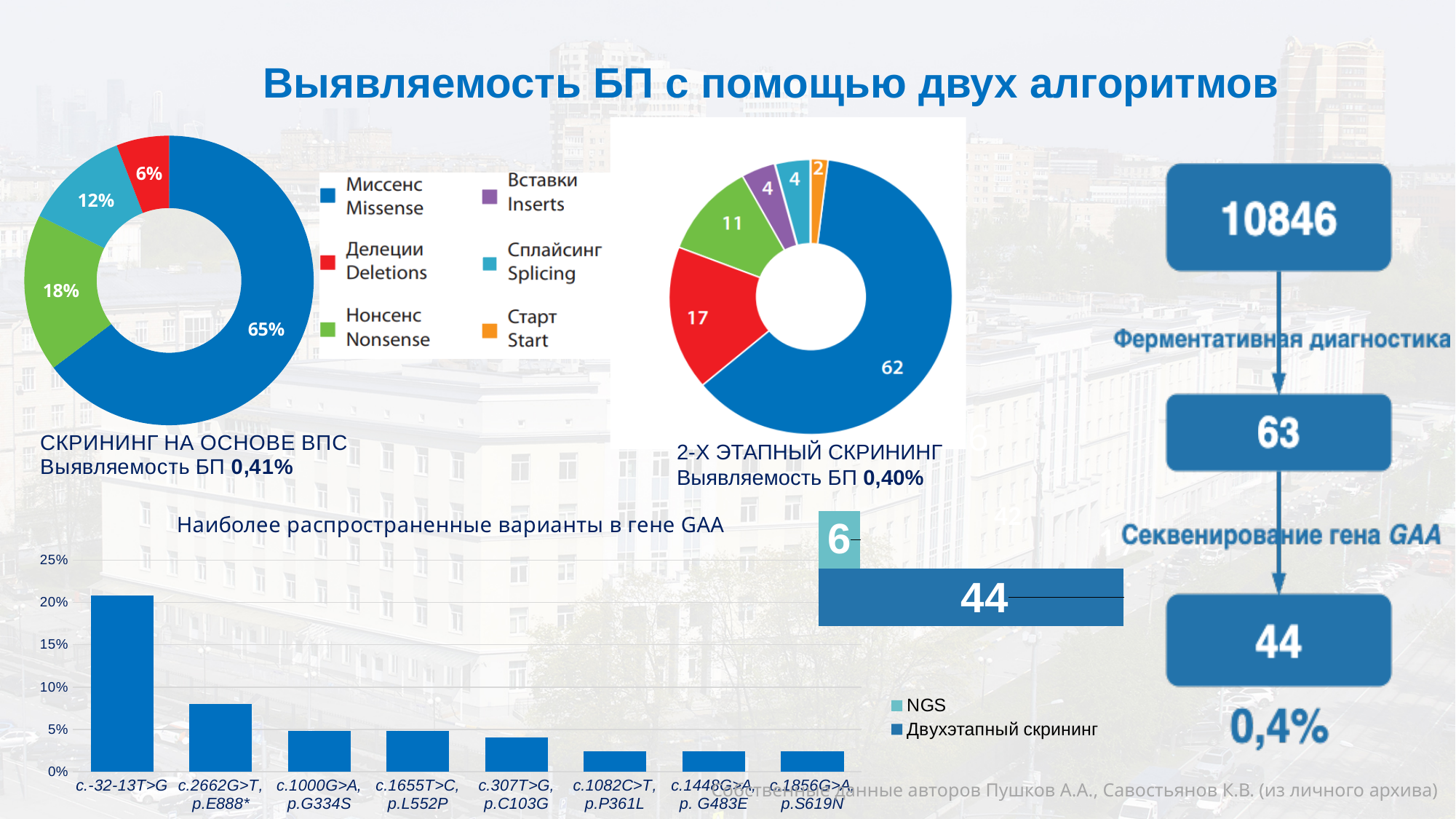
In the right donut chart (2-Х ЭТАПНЫЙ СКРИНИНГ), how many slices are there? 6 In the bar chart 'Наиболее распространенные варианты в гене GAA', how many variants are shown on the x axis? 8 In the left donut chart (СКРИНИНГ НА ОСНОВЕ ВПС), what is the difference between the green (Nonsense) slice and the teal (Splicing) slice? 6% In the right donut chart (2-Х ЭТАПНЫЙ СКРИНИНГ), what value is shown for the red (Deletions) slice? 17 In the left donut chart (СКРИНИНГ НА ОСНОВЕ ВПС), what share is shown for the largest slice? 65% In the right donut chart (2-Х ЭТАПНЫЙ СКРИНИНГ), what value is shown for the blue (Missense) slice? 62 In the right donut chart (2-Х ЭТАПНЫЙ СКРИНИНГ), which slice has the lowest value? Start (2) In the bar chart 'Наиболее распространенные варианты в гене GAA', which variant has the highest bar? c.-32-13T>G In the bar chart 'Наиболее распространенные варианты в гене GAA', is the value for c.-32-13T>G greater or less than 20%? greater In the left donut chart (СКРИНИНГ НА ОСНОВЕ ВПС), which slice is the smallest? 6% (Deletions) In the horizontal bar chart with the NGS and Двухэтапный скрининг legend, what value is shown for Двухэтапный скрининг? 44 In the left donut chart (СКРИНИНГ НА ОСНОВЕ ВПС), what share is shown for the red (Deletions) slice? 6%